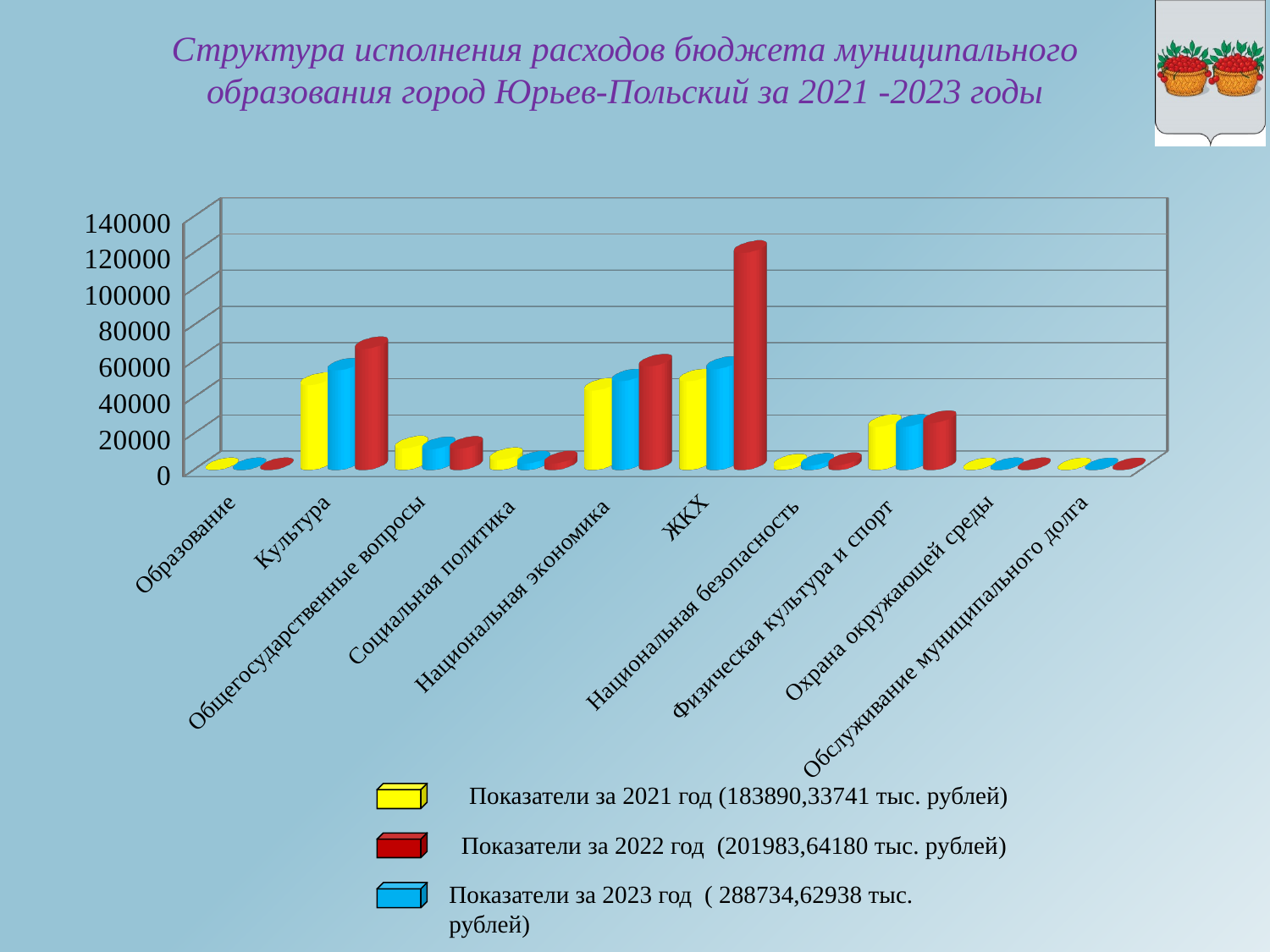
According to the legend, what total is given for the 2023 indicators? 288734,62938 тыс. рублей Is the red bar for ЖКХ greater or less than 100000? greater Is the yellow bar for Культура greater or less than 40000? greater Which category has the tallest bar in the chart? ЖКХ Which category has larger bars, Культура or Образование? Культура How many expenditure categories are shown along the x axis of the chart? 10 Are the bars for Физическая культура и спорт greater or less than 40000? less What is the title of the slide containing the chart? Структура исполнения расходов бюджета муниципального образования город Юрьев-Польский за 2021 -2023 годы Which category has larger bars, Национальная экономика or Социальная политика? Национальная экономика What kind of chart is shown on the slide? bar chart How many series does the legend list? 3